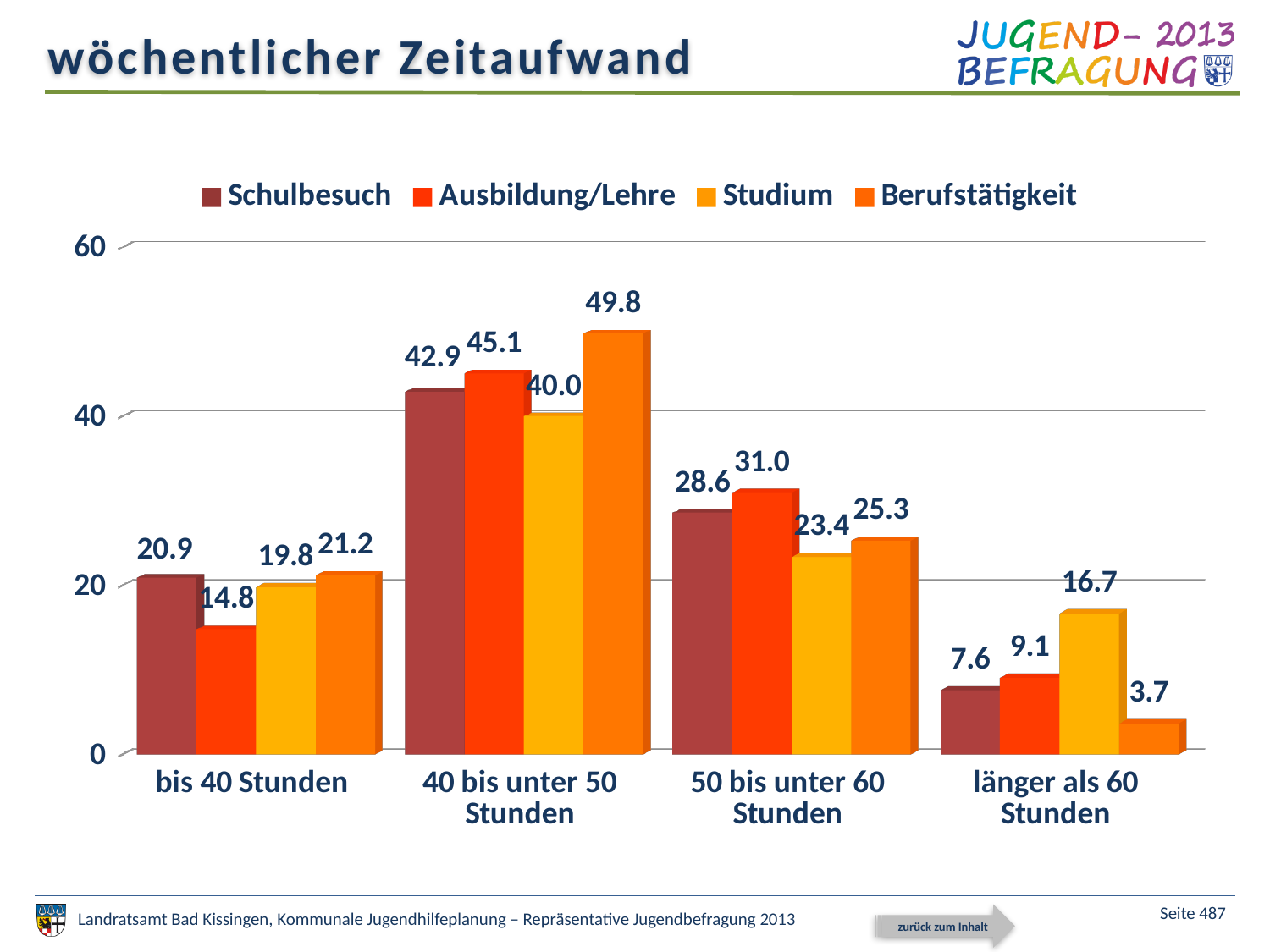
What is the value for Schulbesuch in the 'bis 40 Stunden' category? 20.9 Is the value for Studium in the '40 bis unter 50 Stunden' category greater or less than 20? greater What is the value for Berufstätigkeit in the '40 bis unter 50 Stunden' category? 49.8 How many series does the legend list? 4 What is the difference between Ausbildung/Lehre and Schulbesuch in the '50 bis unter 60 Stunden' category? 2.4 What kind of chart is shown on the slide? bar chart Which is larger in the 'bis 40 Stunden' category: Studium or Ausbildung/Lehre? Studium Which series has the lowest value in the 'länger als 60 Stunden' category? Berufstätigkeit What is the value for Studium in the 'länger als 60 Stunden' category? 16.7 How many categories are shown on the x axis? 4 What is the title of the slide? wöchentlicher Zeitaufwand Which series has the highest value in the '40 bis unter 50 Stunden' category? Berufstätigkeit